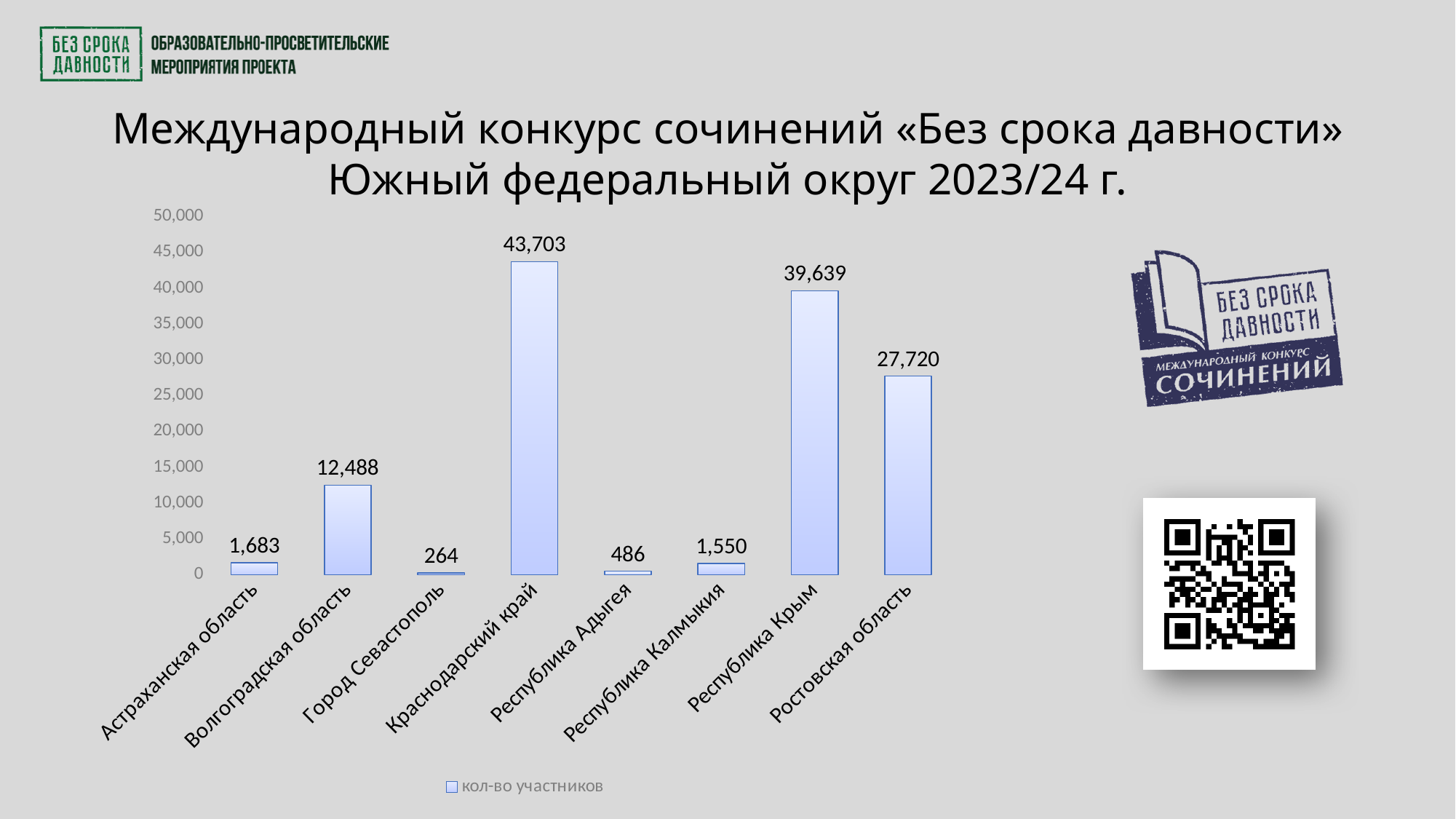
Is the value for Республика Крым greater or less than 35,000? greater Which category has the lowest value? Город Севастополь What is the difference between the values for Краснодарский край and Республика Крым? 4,064 What kind of chart is shown on the slide? bar chart What is the value for Республика Калмыкия? 1,550 Which is larger, the value for Волгоградская область or the value for Астраханская область? Волгоградская область How many categories are shown on the x axis? 8 Which category has the highest value? Краснодарский край What is the value for Краснодарский край? 43,703 What is the value for Ростовская область? 27,720 How many series does the legend list? 1 What is the legend entry for the series? кол-во участников